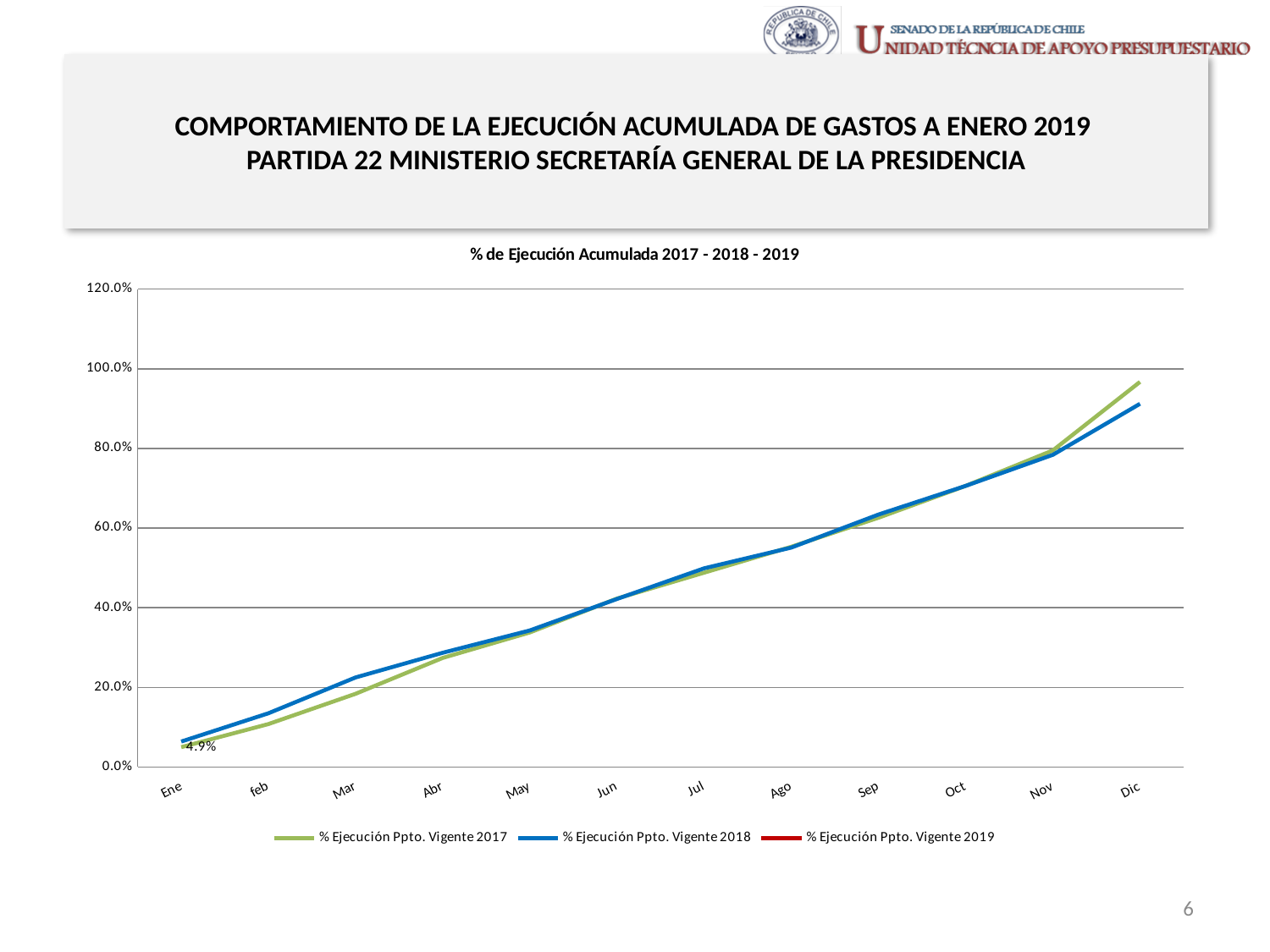
What kind of chart is shown on the slide? line chart In Dic, which series is higher: % Ejecución Ppto. Vigente 2017 or % Ejecución Ppto. Vigente 2018? % Ejecución Ppto. Vigente 2017 What is the title of the chart? % de Ejecución Acumulada 2017 - 2018 - 2019 In which month does % Ejecución Ppto. Vigente 2017 reach its highest value? Dic Is the value for % Ejecución Ppto. Vigente 2017 in Dic greater or less than 80.0%? greater Is the value for % Ejecución Ppto. Vigente 2018 in Dic greater or less than 100.0%? less In Mar, which series is higher: % Ejecución Ppto. Vigente 2017 or % Ejecución Ppto. Vigente 2018? % Ejecución Ppto. Vigente 2018 What data label is printed on the chart at Ene? 4.9% How many months are shown along the x axis? 12 Do the values for % Ejecución Ppto. Vigente 2017 rise or fall from Ene to Dic? rise Is the value for % Ejecución Ppto. Vigente 2018 in Oct greater or less than 60.0%? greater How many series does the legend list? 3